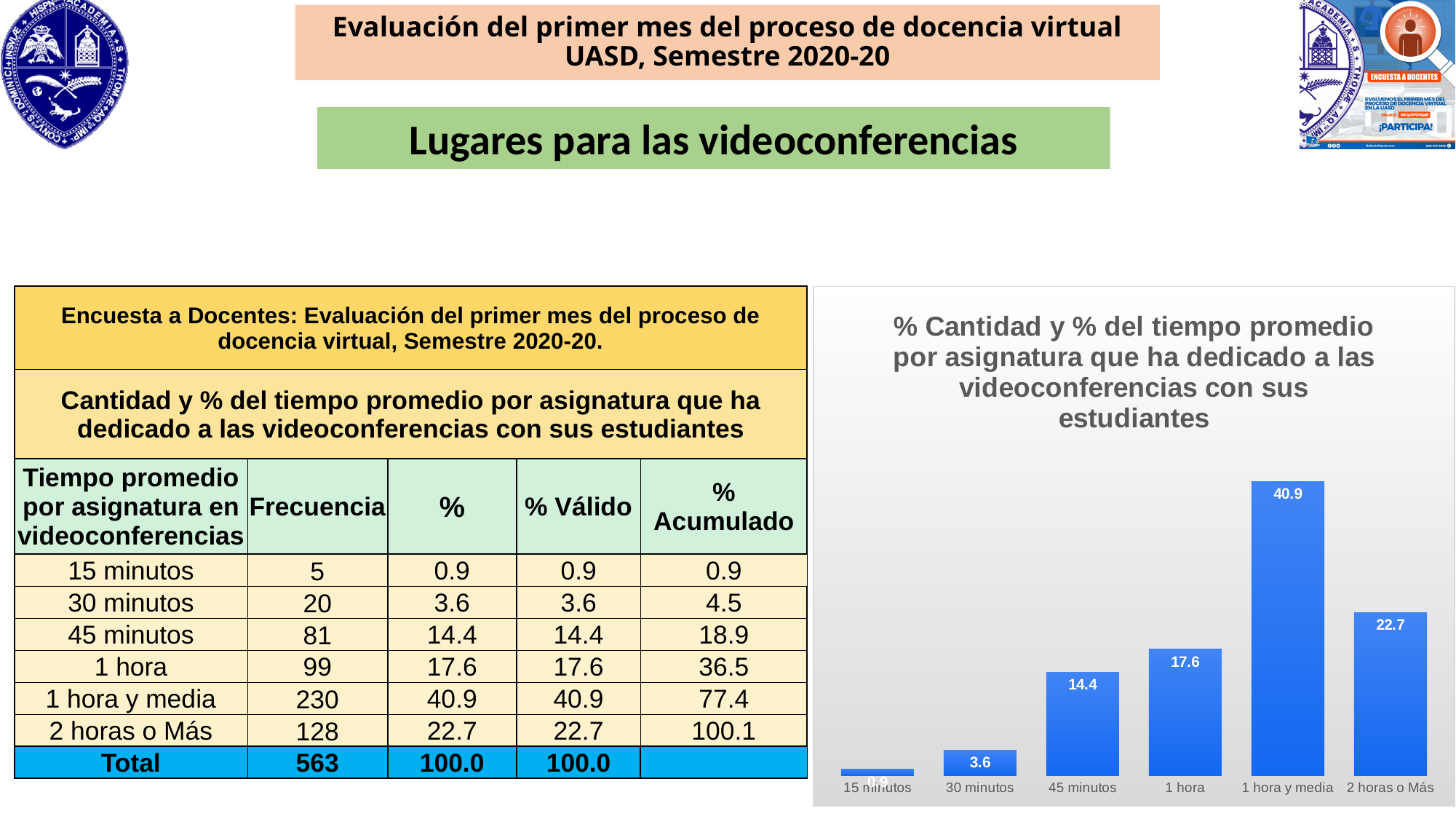
What is the value for '1 hora y media' in the chart? 40.9 What is the value for '45 minutos' in the chart? 14.4 What is the difference between the values for '1 hora y media' and '2 horas o Más'? 18.2 How many categories are shown on the x axis of the chart? 6 What is the value for '30 minutos' in the chart? 3.6 What is the difference between the values for '1 hora' and '45 minutos'? 3.2 What kind of chart is shown on the slide? bar chart Do the values rise or fall from '15 minutos' to '1 hora y media' along the x axis? rise Which category has the lowest value in the chart? 15 minutos Which is larger, the value for '1 hora' or the value for '30 minutos'? 1 hora Which category has the highest value in the chart? 1 hora y media What is the value for '2 horas o Más' in the chart? 22.7